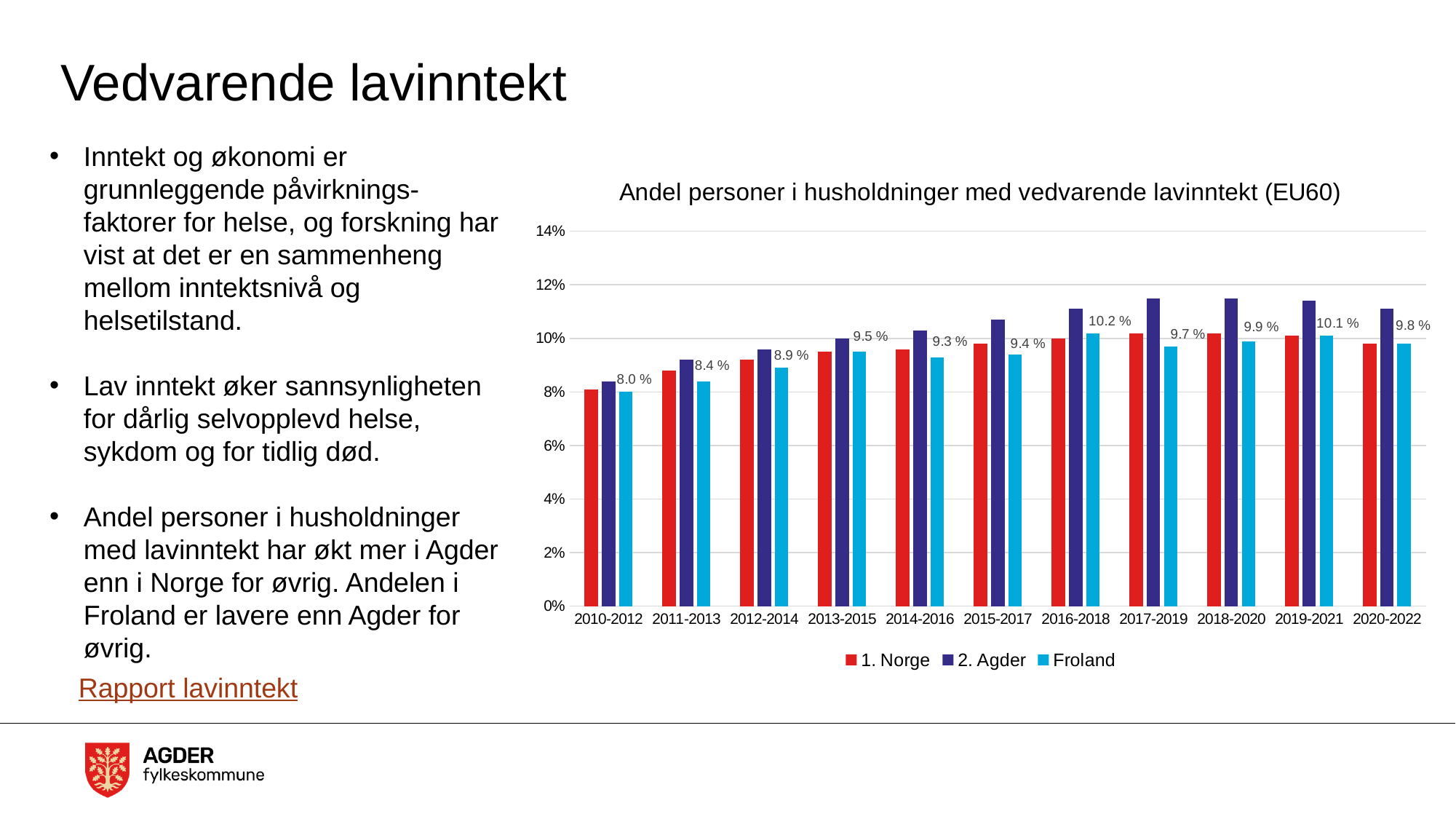
How many series does the legend list? 3 In which period is the Froland value highest? 2016-2018 In 2020-2022, which is larger: the value for 1. Norge or for 2. Agder? 2. Agder What is the value for Froland in 2016-2018? 10.2 % How many periods are shown on the x axis? 11 What is the value for Froland in 2020-2022? 9.8 % What kind of chart is shown on the slide? Bar chart What is the difference between the Froland values for 2016-2018 and 2010-2012? 2.2 percentage points Is the value for 1. Norge in 2010-2012 greater or less than 10%? less In which period is the Froland value lowest? 2010-2012 Is the value for 2. Agder in 2017-2019 greater or less than 10%? greater What is the value for Froland in 2010-2012? 8.0 %